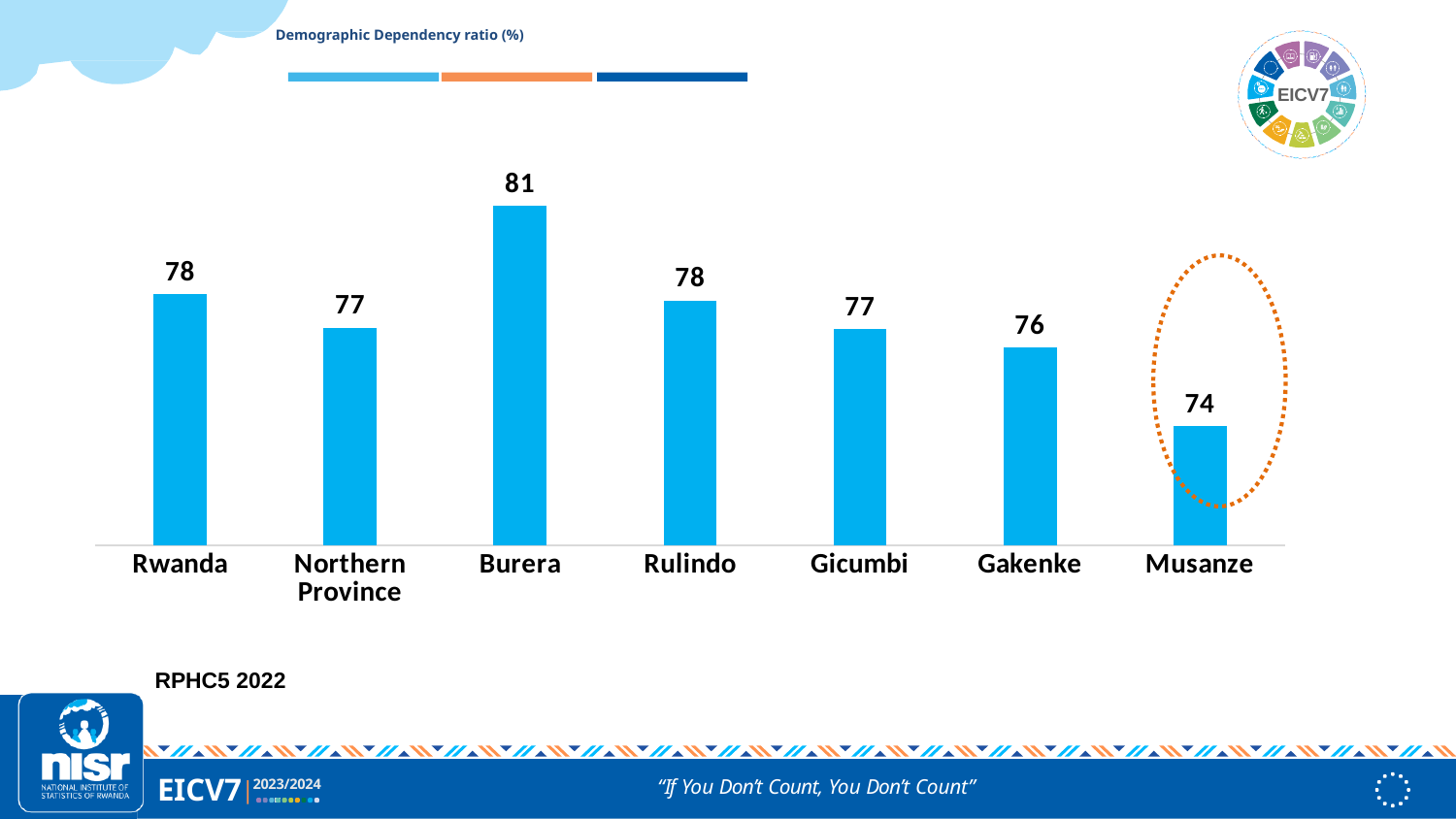
How many categories are shown in the chart? 7 What is the difference between the demographic dependency ratio of Burera and Musanze? 7 What is the demographic dependency ratio for Burera? 81 What is the title of the chart? Demographic Dependency ratio (%) What is the difference between the demographic dependency ratio of Rwanda and Northern Province? 1 What kind of chart is shown on the slide? Bar chart What is the demographic dependency ratio for Gakenke? 76 Which category has the lowest demographic dependency ratio? Musanze What is the demographic dependency ratio for Rwanda? 78 Which category has the highest demographic dependency ratio? Burera What is the demographic dependency ratio for Musanze? 74 Which has a higher demographic dependency ratio, Gicumbi or Gakenke? Gicumbi